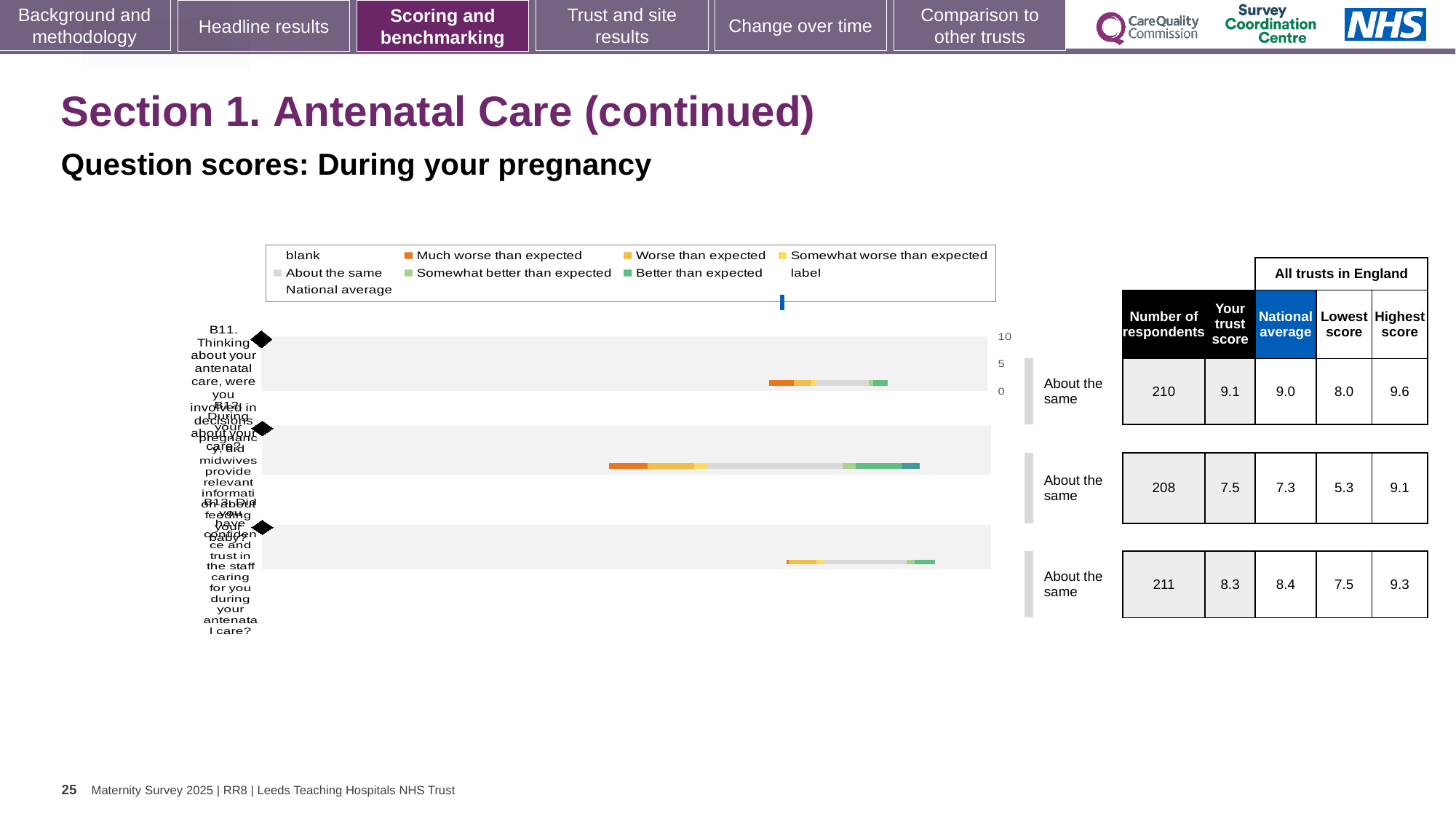
In the table beside the chart, which of the three questions has the lowest 'Your trust score'? B12 (7.5) What benchmark category is shown next to each of the three bars in the chart? About the same What colour does the legend use for 'Much worse than expected'? Orange How many entries does the chart legend list? 9 In the table beside the chart, what is the number of respondents for the first question (B11)? 210 In the table beside the chart, what is the highest score for the third question (B13)? 9.3 What is the first legend entry in the chart? blank In the table beside the chart, what is the difference between the highest score and the lowest score for the second question (B12)? 3.8 What kind of chart is shown on the slide? Bar chart In the table beside the chart, what is the national average for the second question (B12)? 7.3 In the table beside the chart, what is 'Your trust score' for the first question (B11)? 9.1 How many survey questions (bars) are plotted in the chart? 3